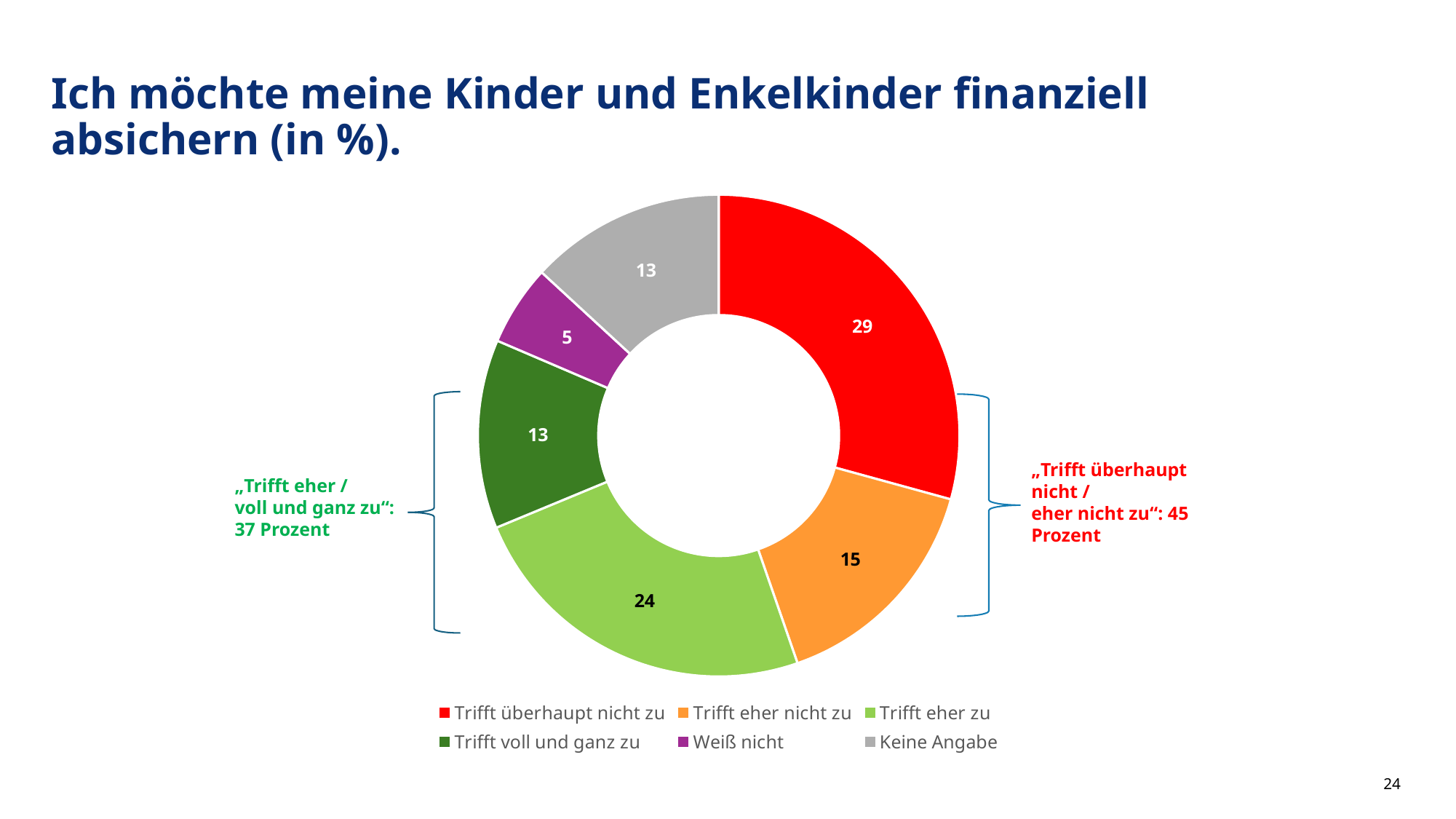
What is the value for "Trifft überhaupt nicht zu"? 29 What colour is the "Trifft voll und ganz zu" slice? Dark green What is the value for "Trifft eher zu"? 24 Which is larger, the value for "Trifft eher zu" or the value for "Trifft voll und ganz zu"? Trifft eher zu What is the difference between the values for "Keine Angabe" and "Weiß nicht"? 8 Which category has the smallest slice? Weiß nicht Which category has the largest slice? Trifft überhaupt nicht zu What kind of chart is shown on the slide? Doughnut (pie) chart How many categories does the chart show? 6 What is the value for "Weiß nicht"? 5 What is the value for "Trifft eher nicht zu"? 15 What is the difference between the values for "Trifft überhaupt nicht zu" and "Trifft eher nicht zu"? 14